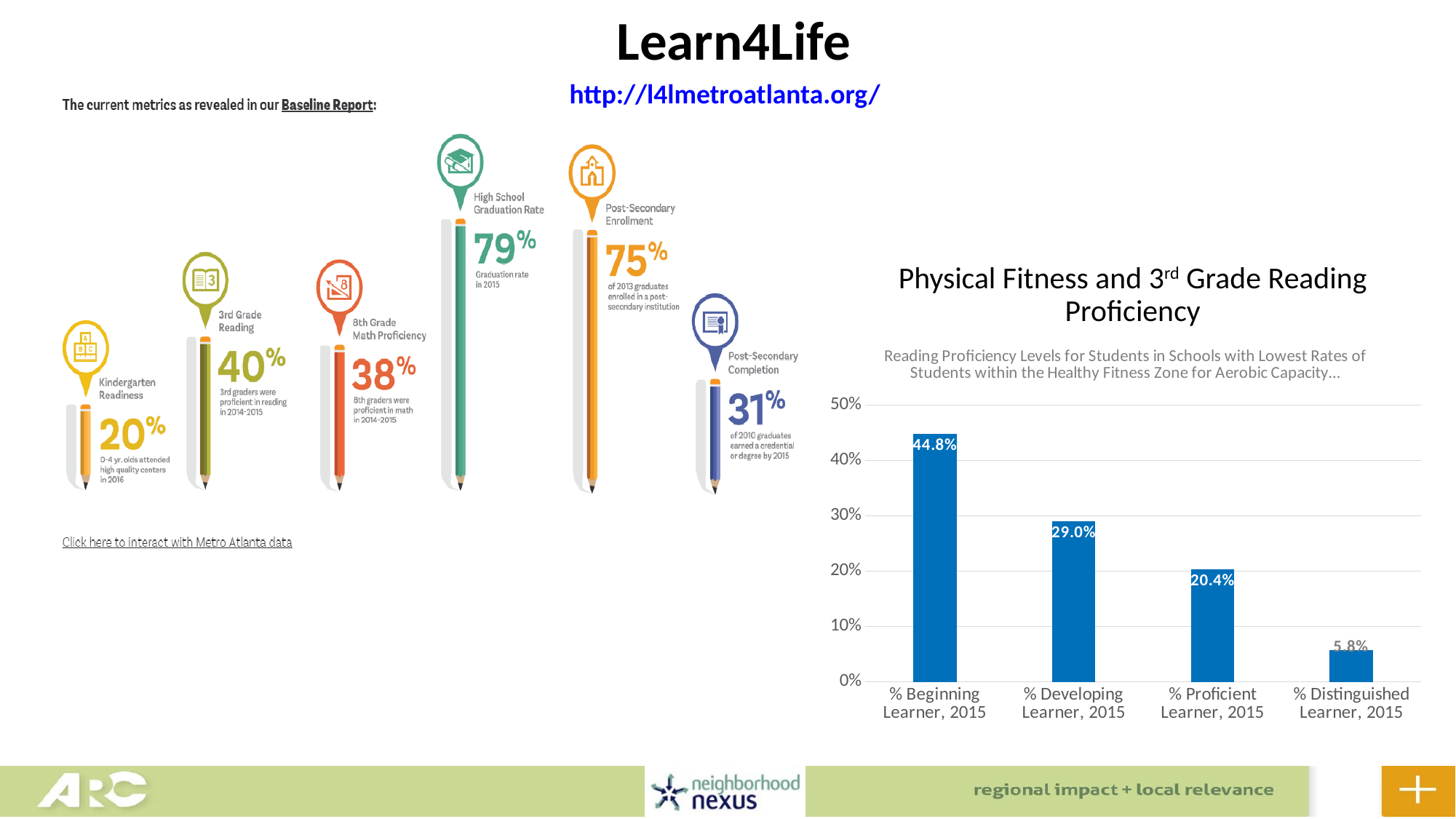
What is the value for % Beginning Learner, 2015 in the Physical Fitness and 3rd Grade Reading Proficiency chart? 44.8% What is the value for % Proficient Learner, 2015 in the Physical Fitness and 3rd Grade Reading Proficiency chart? 20.4% Which category has the highest value in the Physical Fitness and 3rd Grade Reading Proficiency chart? % Beginning Learner, 2015 How many categories are shown in the Physical Fitness and 3rd Grade Reading Proficiency chart? 4 What is the value for % Distinguished Learner, 2015 in the Physical Fitness and 3rd Grade Reading Proficiency chart? 5.8% Which category has the lowest value in the Physical Fitness and 3rd Grade Reading Proficiency chart? % Distinguished Learner, 2015 What is the difference between the values for % Beginning Learner, 2015 and % Developing Learner, 2015 in the Physical Fitness and 3rd Grade Reading Proficiency chart? 15.8% Is the value for % Developing Learner, 2015 greater or less than 30% in the Physical Fitness and 3rd Grade Reading Proficiency chart? less Do the values rise or fall from left to right across the categories in the Physical Fitness and 3rd Grade Reading Proficiency chart? fall What is the value for % Developing Learner, 2015 in the Physical Fitness and 3rd Grade Reading Proficiency chart? 29.0% What kind of chart is the Physical Fitness and 3rd Grade Reading Proficiency chart? bar chart Which is larger in the Physical Fitness and 3rd Grade Reading Proficiency chart: % Proficient Learner, 2015 or % Distinguished Learner, 2015? % Proficient Learner, 2015